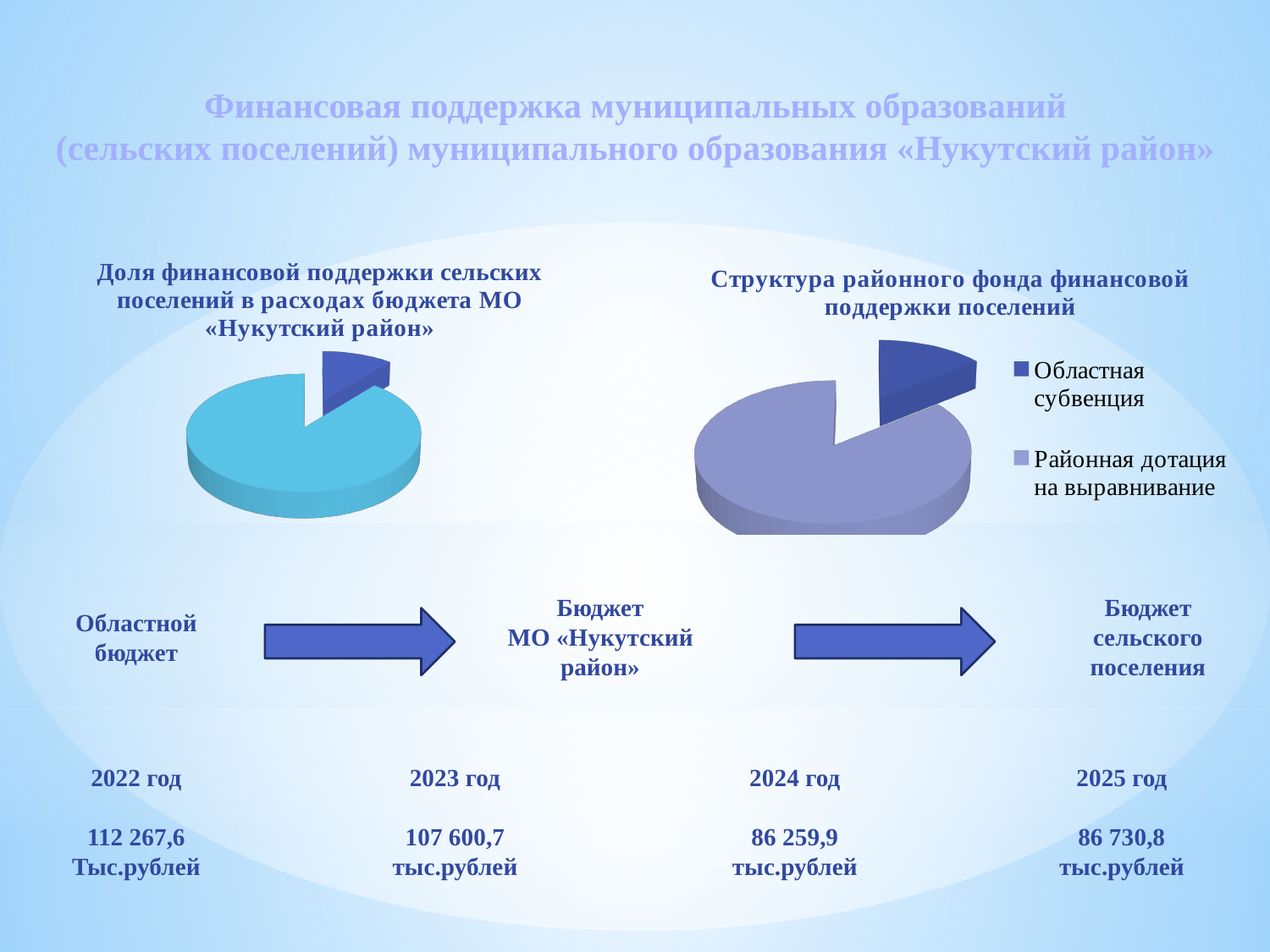
In the right chart «Структура районного фонда финансовой поддержки поселений», which category has the smallest slice? Областная субвенция How many charts are shown on the slide? 2 In the right chart «Структура районного фонда финансовой поддержки поселений», how many entries does the legend list? 2 In the left chart «Доля финансовой поддержки сельских поселений в расходах бюджета МО «Нукутский район»», how many slices does the pie have? 2 What kind of chart is the left chart titled «Доля финансовой поддержки сельских поселений в расходах бюджета МО «Нукутский район»»? Pie chart In the right chart «Структура районного фонда финансовой поддержки поселений», what colour is the slice for Областная субвенция? Dark blue In the right chart «Структура районного фонда финансовой поддержки поселений», which is larger: Областная субвенция or Районная дотация на выравнивание? Районная дотация на выравнивание In the right chart «Структура районного фонда финансовой поддержки поселений», which category has the largest slice? Районная дотация на выравнивание What kind of chart is the right chart titled «Структура районного фонда финансовой поддержки поселений»? Pie chart In the right chart «Структура районного фонда финансовой поддержки поселений», how many slices does the pie have? 2